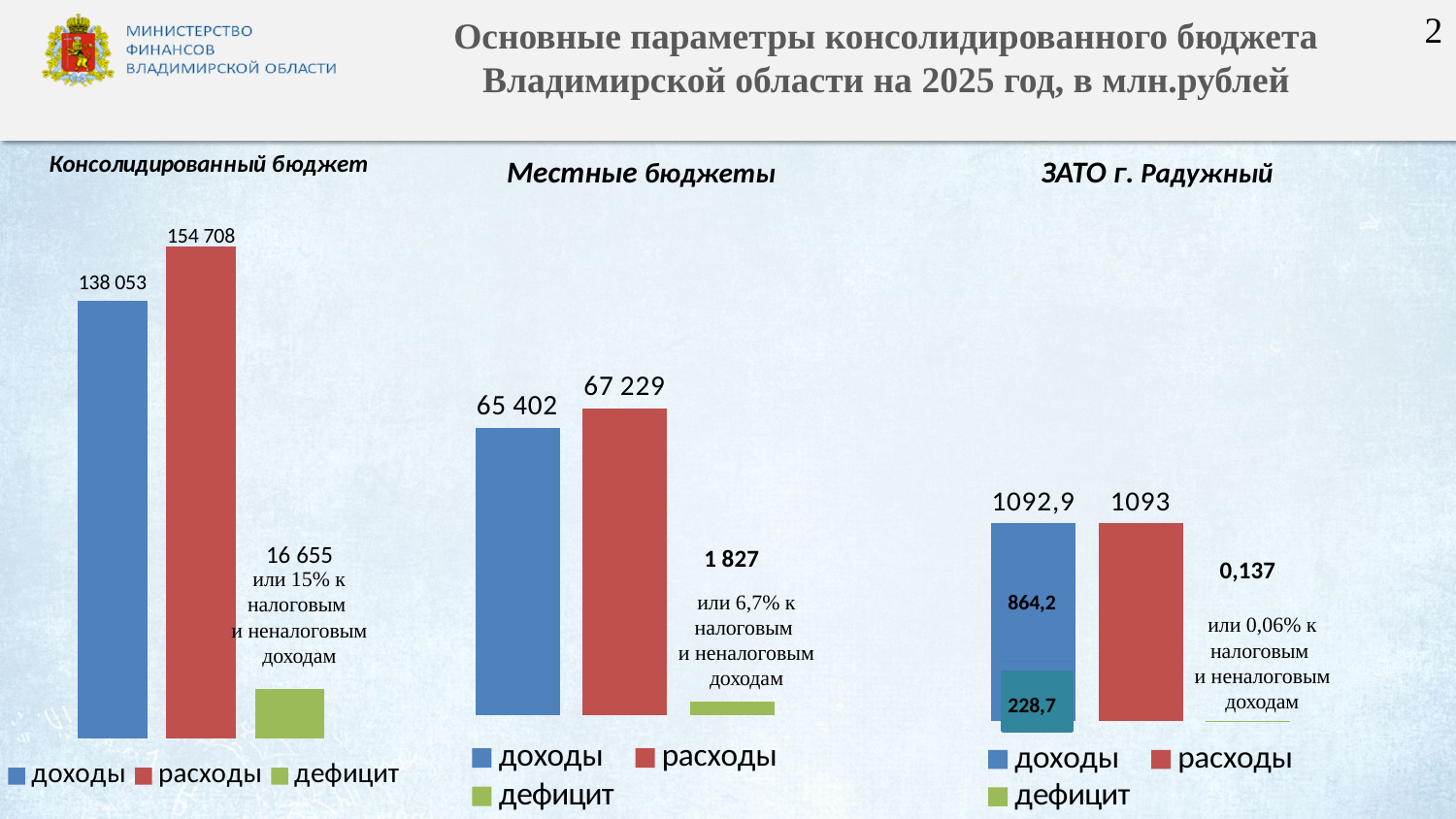
On the 'ЗАТО г. Радужный' chart, what is the value for дефицит? 0,137 On the 'Местные бюджеты' chart, which is larger, доходы or расходы? расходы On the 'Консолидированный бюджет' chart, what is the difference between расходы and доходы? 16 655 On the 'ЗАТО г. Радужный' chart, what are the two labelled segments of the доходы bar? 864,2 and 228,7 On the 'Консолидированный бюджет' chart, what is the value for дефицит? 16 655 How many entries does the legend of the 'Консолидированный бюджет' chart list? 3 On the 'Местные бюджеты' chart, which category is the lowest? дефицит On the 'Местные бюджеты' chart, what is the value for дефицит? 1 827 On the 'Местные бюджеты' chart, what is the value for расходы? 67 229 On the 'Консолидированный бюджет' chart, what is the value for расходы? 154 708 On the 'ЗАТО г. Радужный' chart, what is the value for расходы? 1093 On the 'Консолидированный бюджет' chart, what is the value for доходы? 138 053